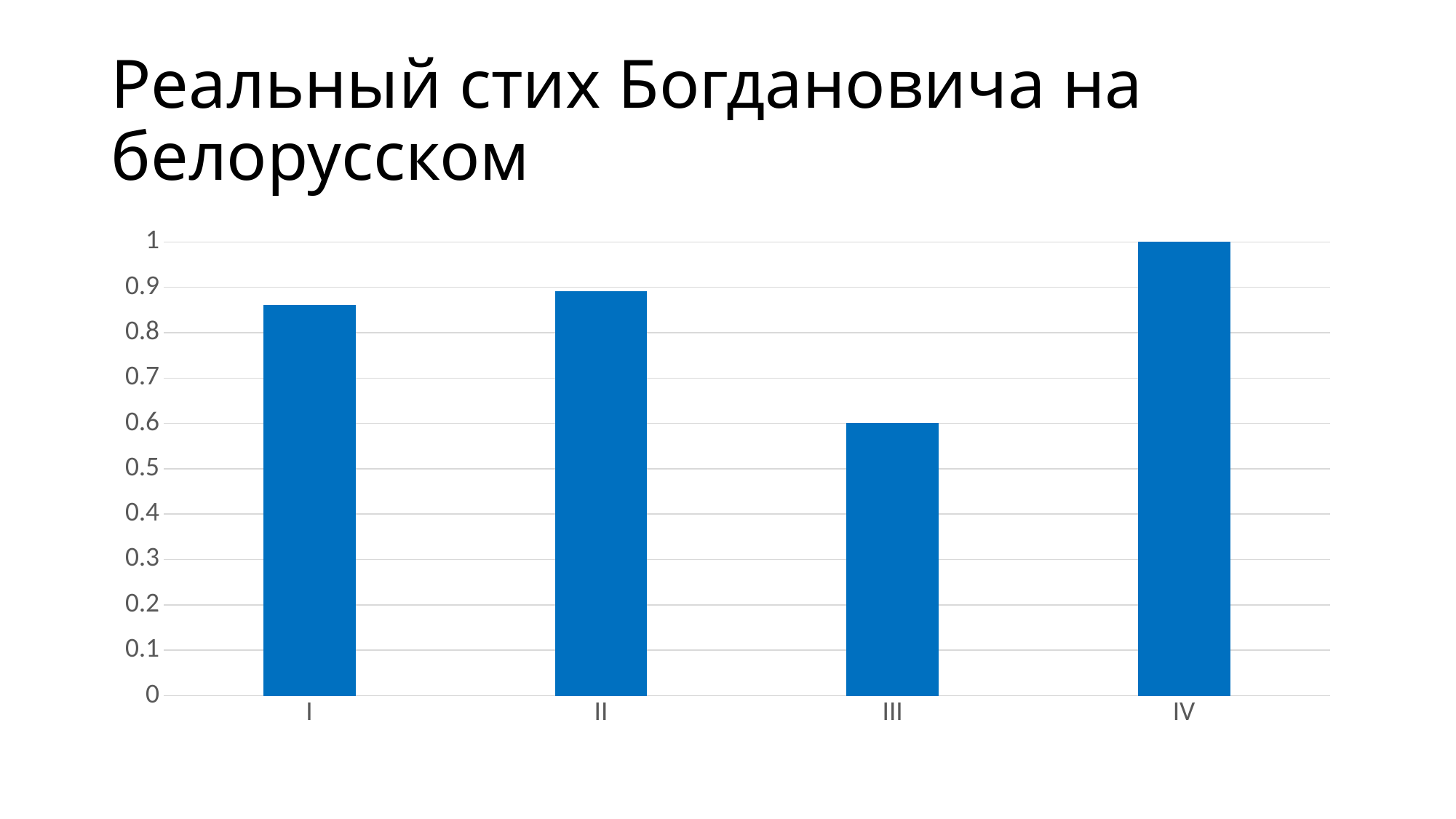
What kind of chart is shown on the slide? bar chart Which category has the lowest bar? III What is the value for category IV? 1 What is the title of the slide containing the chart? Реальный стих Богдановича на белорусском Is the value for I greater or less than 0.8? greater How many categories are shown on the x axis of the chart? 4 What is the difference between the values for IV and III? 0.4 Which category has the highest bar? IV Which is larger, the value for II or the value for III? II What is the value for category III? 0.6 Which is larger, the value for I or the value for IV? IV